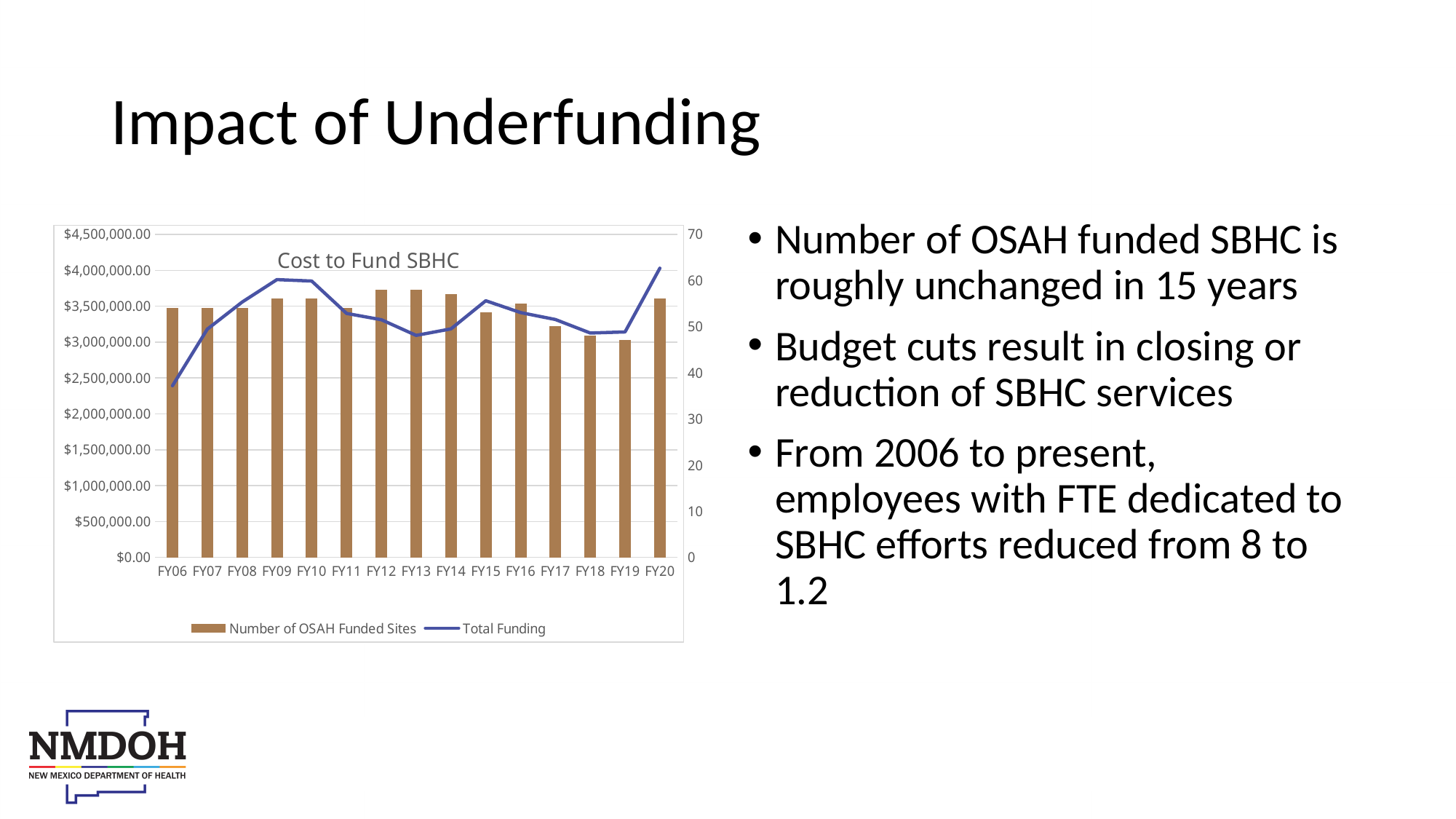
In which fiscal year is Total Funding lowest? FY06 How many series does the chart legend list? 2 Is the Total Funding value for FY06 greater or less than $2,500,000.00? less Which is larger, the Number of OSAH Funded Sites in FY13 or in FY19? FY13 Is the Total Funding value for FY09 greater or less than $3,500,000.00? greater How many fiscal years are shown on the x axis of the chart? 15 What is the title of the chart? Cost to Fund SBHC What kind of chart is shown on the slide? Combined bar and line chart Is the Number of OSAH Funded Sites for FY19 greater or less than 50? less Does Total Funding rise or fall from FY06 to FY09? rise In which fiscal year is Total Funding highest? FY20 Which series is drawn as a line in the chart? Total Funding